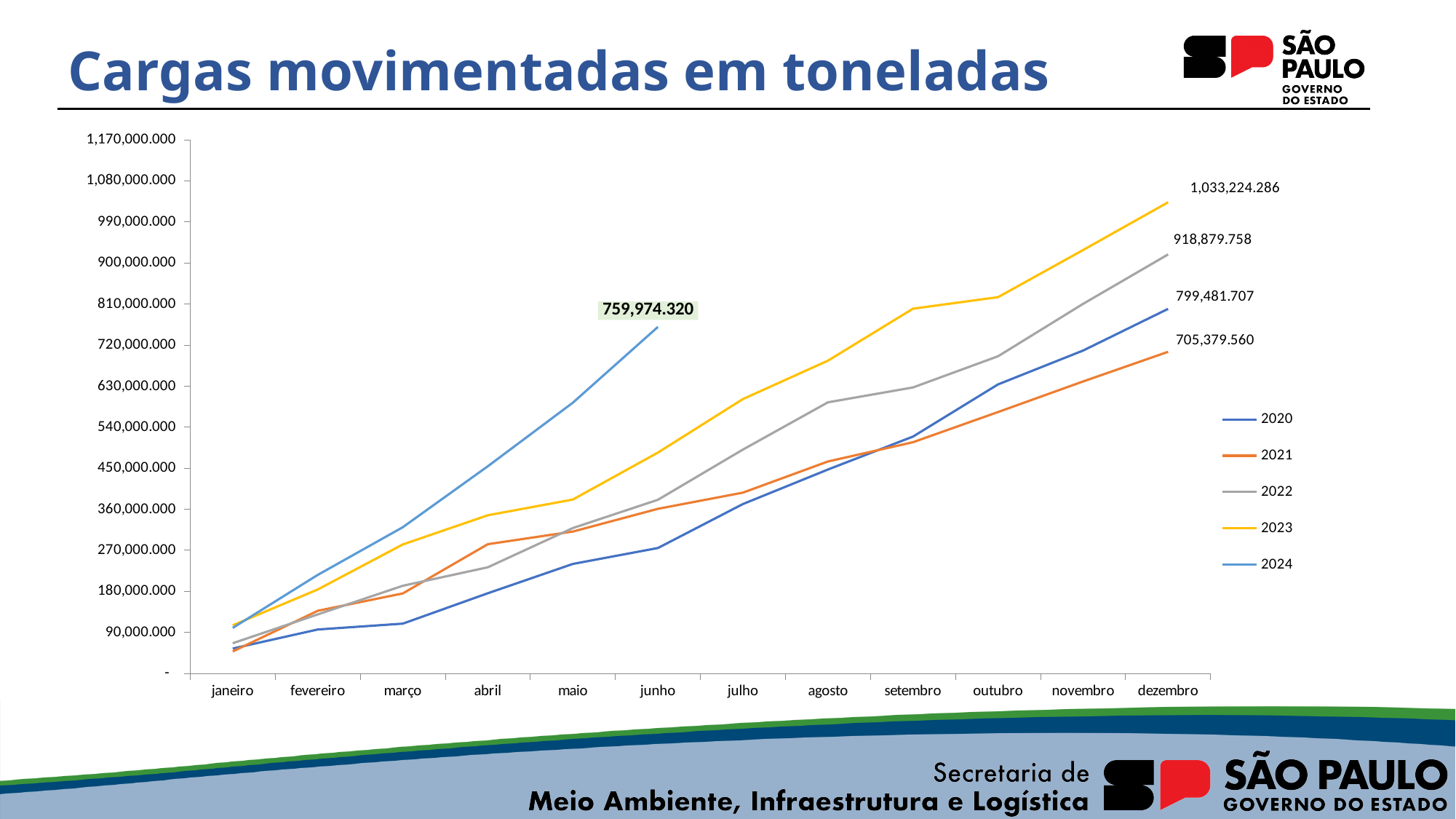
How many months are shown on the x axis? 12 What is the value for 2022 in dezembro? 918,879.758 Which is larger in dezembro, the value for 2020 or the value for 2021? 2020 Is the value for 2024 in maio greater or less than 540,000.000? greater How many series does the legend list? 5 What is the value for 2024 in junho? 759,974.320 What is the difference between the dezembro values for 2023 and 2022? 114,344.528 What is the value for 2021 in dezembro? 705,379.560 What kind of chart is shown on the slide? line chart What is the value for 2023 in dezembro? 1,033,224.286 Which series has the highest value in dezembro? 2023 Which series has the lowest value in dezembro? 2021